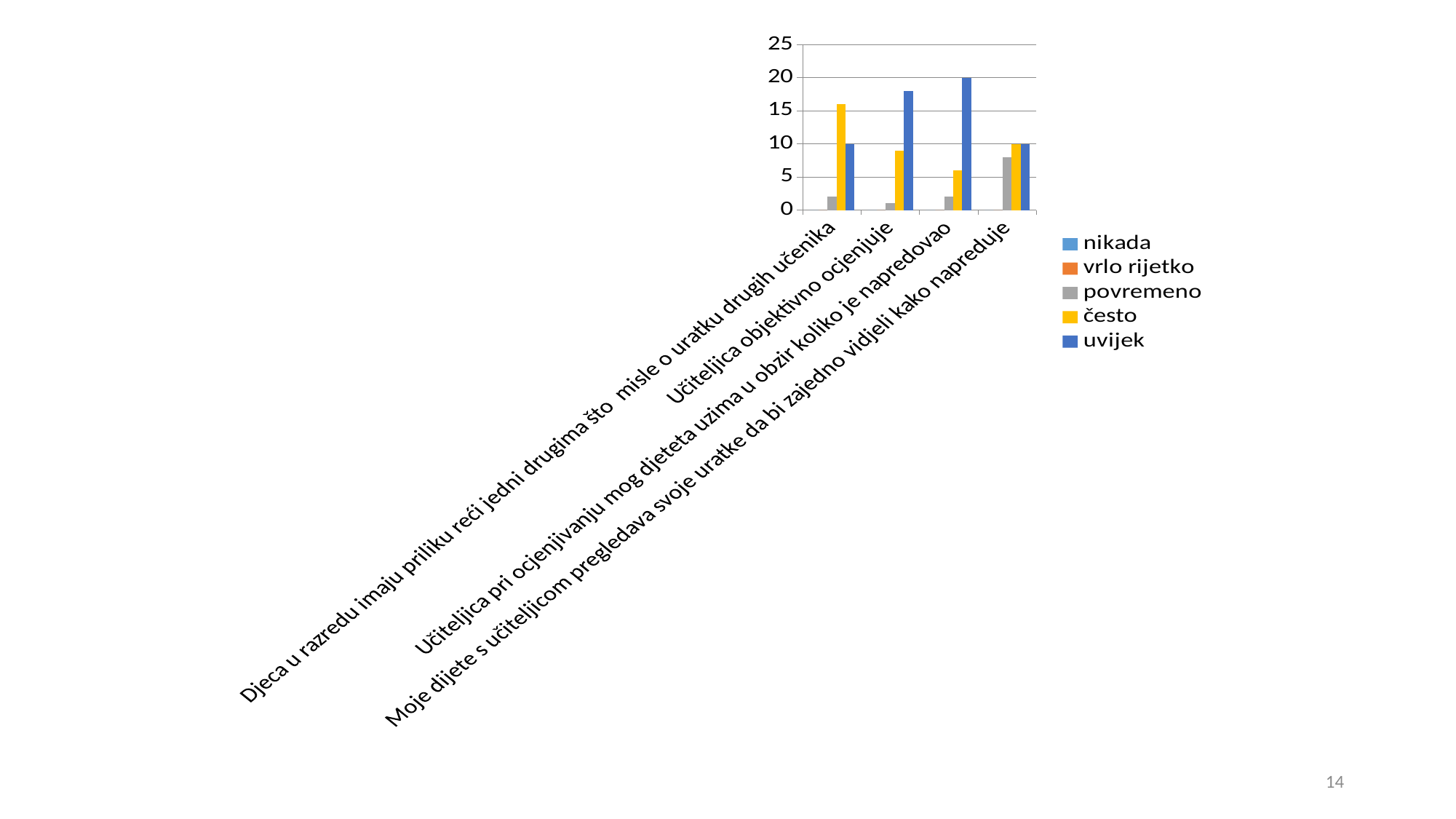
Is the value of 'uvijek' for 'Učiteljica objektivno ocjenjuje' greater or less than 15? greater For 'Učiteljica objektivno ocjenjuje', which is larger: 'često' or 'uvijek'? uvijek Is the value of 'često' for 'Djeca u razredu imaju priliku reći jedni drugima što misle o uratku drugih učenika' greater or less than 15? greater For 'Djeca u razredu imaju priliku reći jedni drugima što misle o uratku drugih učenika', which is larger: 'često' or 'uvijek'? često What is the value of 'uvijek' for 'Djeca u razredu imaju priliku reći jedni drugima što misle o uratku drugih učenika'? 10 How many series does the legend list? 5 Which category has the highest 'uvijek' value? Učiteljica pri ocjenjivanju mog djeteta uzima u obzir koliko je napredovao Is the value of 'povremeno' for 'Moje dijete s učiteljicom pregledava svoje uratke da bi zajedno vidjeli kako napreduje' greater or less than 10? less What kind of chart is shown on the slide? bar chart Which legend entry is shown in yellow? često How many categories are shown on the x axis? 4 What is the value of 'uvijek' for 'Učiteljica pri ocjenjivanju mog djeteta uzima u obzir koliko je napredovao'? 20